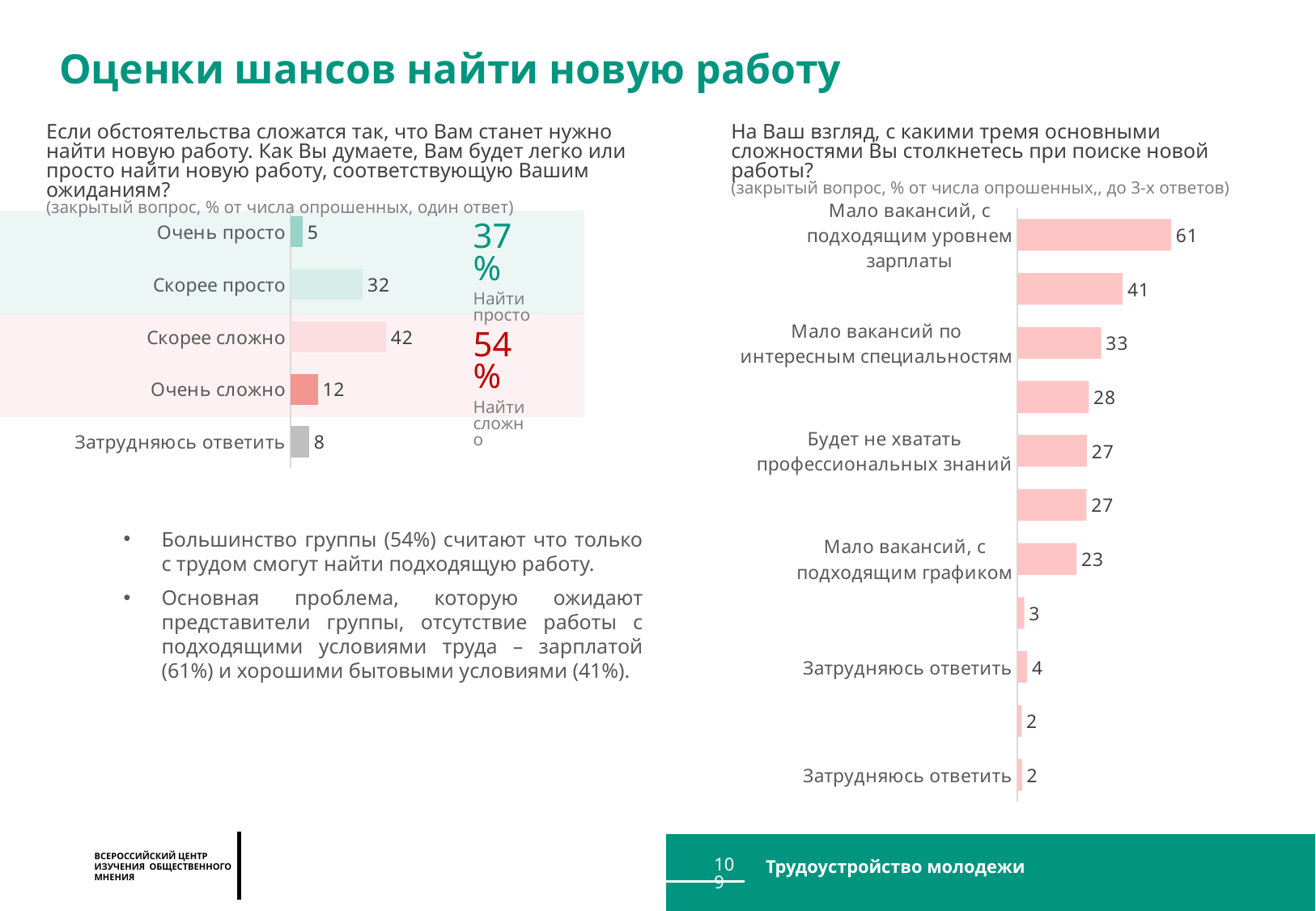
On the left chart, which category has the lowest value? Очень просто On the right chart, what is the value for "Будет не хватать профессиональных знаний"? 27 What type of chart is the right chart? Bar chart On the left chart, what is the value for "Очень просто"? 5 On the right chart, what is the value for "Мало вакансий, с подходящим уровнем зарплаты"? 61 On the left chart, what is the value for "Скорее сложно"? 42 On the right chart, what is the value for "Мало вакансий по интересным специальностям"? 33 On the left chart, what is the difference between "Скорее сложно" and "Скорее просто"? 10 On the right chart, which is larger: "Мало вакансий, с подходящим графиком" or "Мало вакансий по интересным специальностям"? Мало вакансий по интересным специальностям On the right chart, what is the difference between "Мало вакансий, с подходящим уровнем зарплаты" and "Мало вакансий, с подходящим графиком"? 38 On the left chart, how many categories are shown? 5 On the left chart, which category has the highest value? Скорее сложно